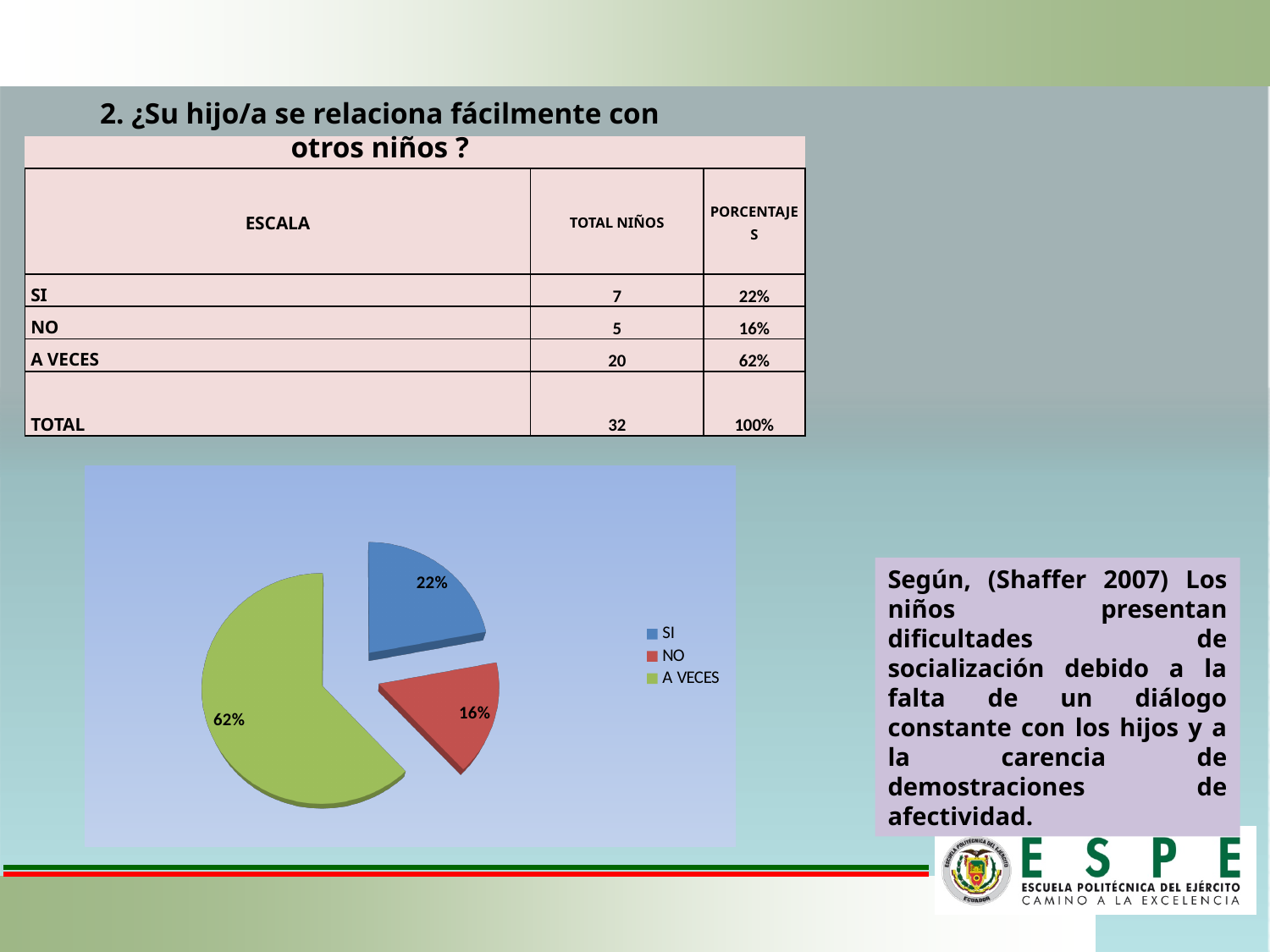
What percentage does the A VECES slice show in the pie chart? 62% What is the difference in percentage points between the A VECES slice and the SI slice? 40 What colour is the NO slice in the pie chart? red Which category has the largest slice in the pie chart? A VECES Which category has the smallest slice in the pie chart? NO What percentage does the NO slice show in the pie chart? 16% What colour is the A VECES slice in the pie chart? green How many slices does the pie chart have? 3 What kind of chart is shown on the slide? pie chart How many entries does the legend of the pie chart list? 3 What percentage does the SI slice show in the pie chart? 22% Which slice is larger in the pie chart, SI or NO? SI